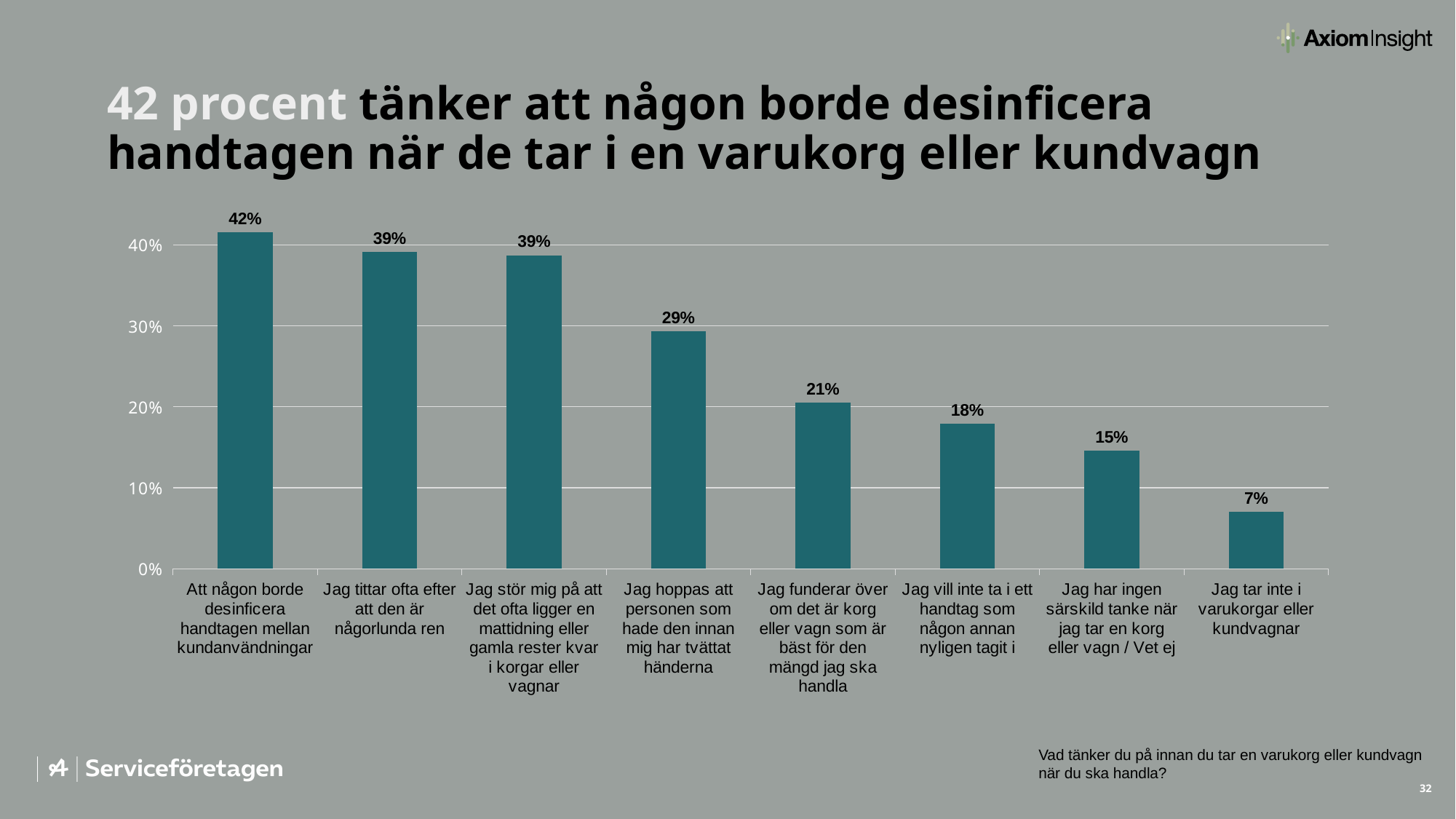
Is the value for "Jag har ingen särskild tanke när jag tar en korg eller vagn / Vet ej" greater or less than 20%? less What is the value for "Jag tar inte i varukorgar eller kundvagnar"? 7% What is the difference between the values for "Jag funderar över om det är korg eller vagn som är bäst för den mängd jag ska handla" and "Jag har ingen särskild tanke när jag tar en korg eller vagn / Vet ej"? 6% Which category has the highest value? Att någon borde desinficera handtagen mellan kundanvändningar What is the value for "Jag vill inte ta i ett handtag som någon annan nyligen tagit i"? 18% Which category has the lowest value? Jag tar inte i varukorgar eller kundvagnar What is the value for "Jag hoppas att personen som hade den innan mig har tvättat händerna"? 29% What kind of chart is shown on the slide? bar chart What is the difference between the values for "Att någon borde desinficera handtagen mellan kundanvändningar" and "Jag tar inte i varukorgar eller kundvagnar"? 35% How many categories are shown in the chart? 8 Do the values rise or fall from left to right along the x axis? fall Which is larger: the value for "Jag hoppas att personen som hade den innan mig har tvättat händerna" or the value for "Jag funderar över om det är korg eller vagn som är bäst för den mängd jag ska handla"? Jag hoppas att personen som hade den innan mig har tvättat händerna